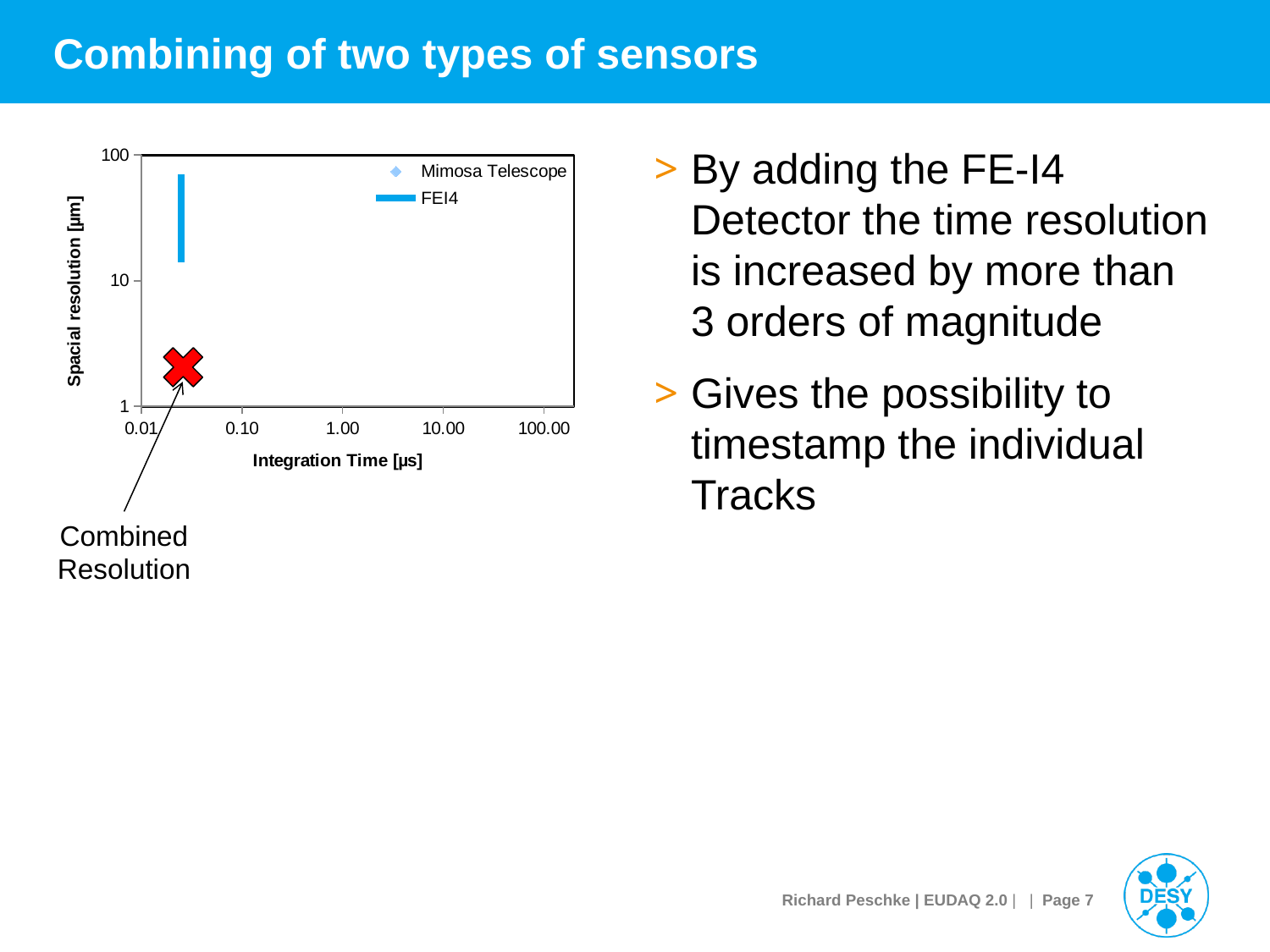
What kind of chart is shown on the slide? scatter chart Is the integration time of the FEI4 series greater or less than 1.00 µs? less Is the spatial resolution of the FEI4 series greater or less than 10 µm? greater Which has the lower spatial resolution value on the chart, the FEI4 series or the Combined Resolution point? Combined Resolution Is the spatial resolution of the point marked 'Combined Resolution' greater or less than 10 µm? less What is the lowest value shown on the chart's y axis? 1 What is the label of the chart's x axis? Integration Time [µs] How many series does the chart legend list? 2 What are the two series named in the chart legend? Mimosa Telescope and FEI4